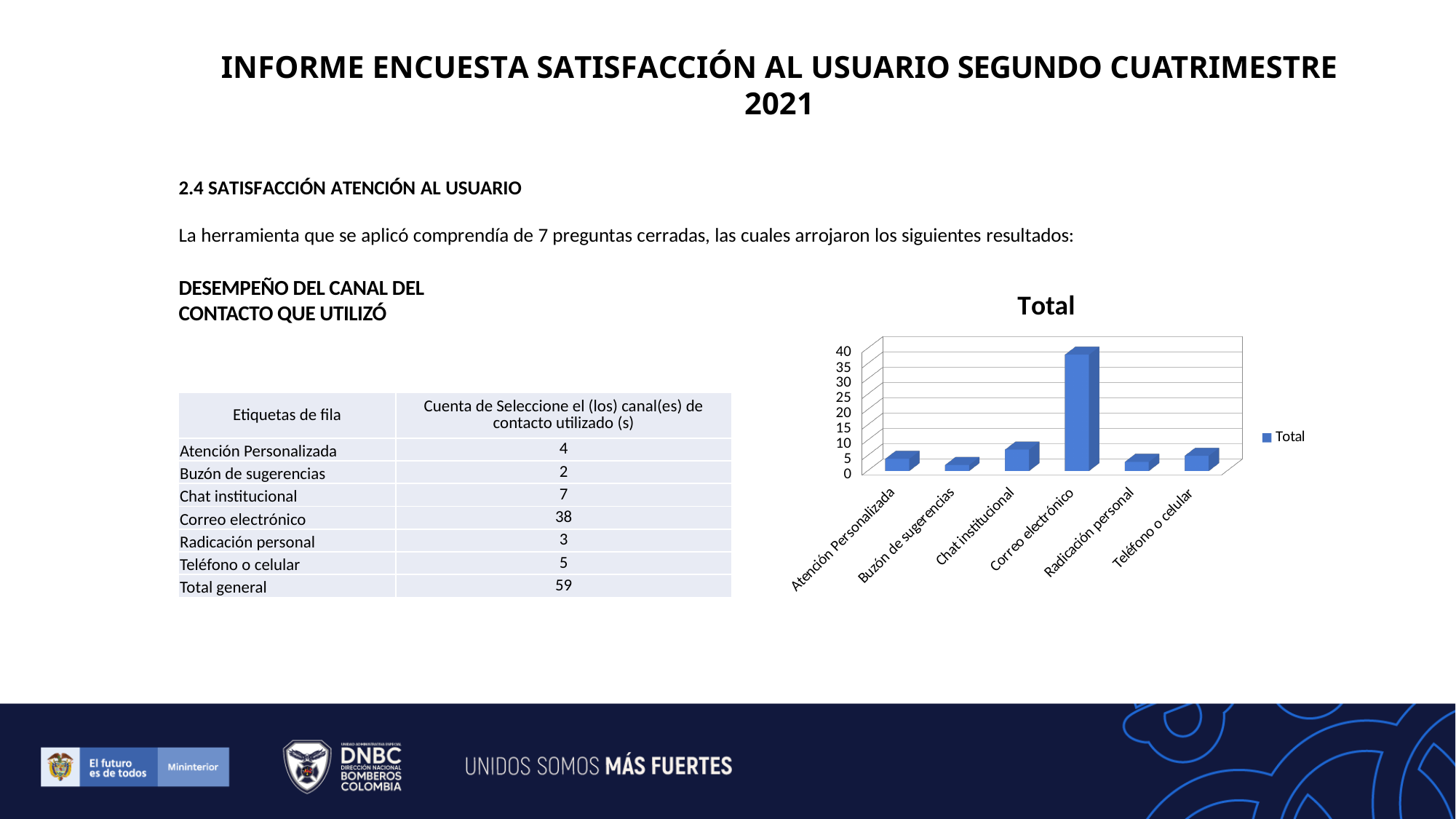
How many series does the chart legend list? 1 Is the value for Correo electrónico greater or less than 35? greater How many categories are shown on the x axis of the chart? 6 Which is larger, the value for Chat institucional or the value for Teléfono o celular? Chat institucional Is the value for Chat institucional greater or less than 10? less What kind of chart is shown on the slide? bar chart Which category has the highest bar in the chart? Correo electrónico Which category has the lowest bar in the chart? Buzón de sugerencias What is the title of the chart? Total What is the difference between the value for Correo electrónico and the value for Chat institucional? 31 What is the value for Chat institucional? 7 What is the value for Correo electrónico? 38